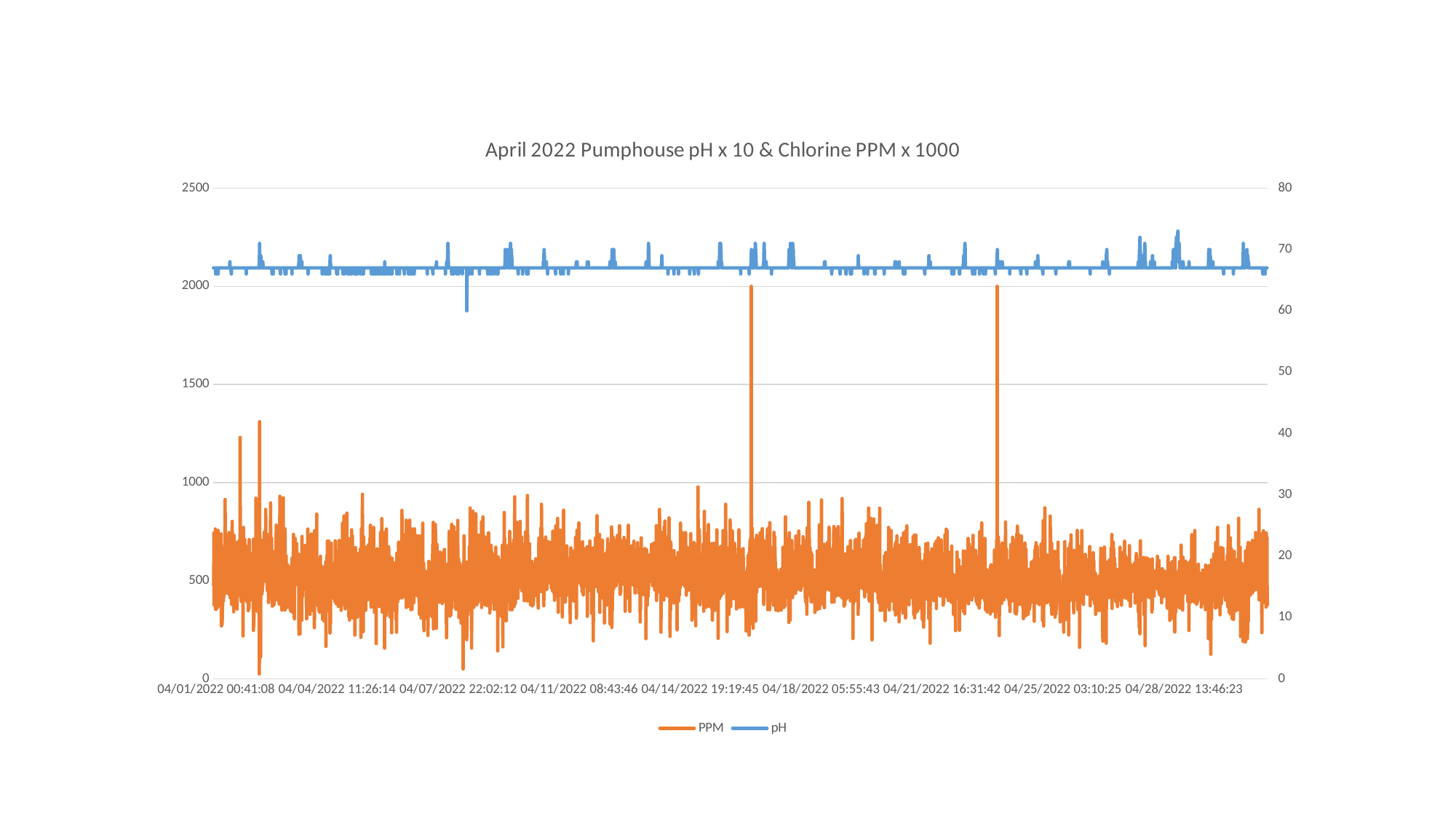
What is the last date label on the x axis? 04/28/2022 13:46:23 What is the title of the chart? April 2022 Pumphouse pH x 10 & Chlorine PPM x 1000 Which series is drawn in orange? PPM Which series is plotted higher on the chart, PPM or pH? pH How many date labels are shown along the x axis? 9 On the left axis, are the typical PPM values greater or less than 1000? less On the right axis, is the pH line mostly greater or less than 60? greater What kind of chart is shown on the slide? line chart What is the highest value shown on the right vertical axis? 80 What is the first date label on the x axis? 04/01/2022 00:41:08 How many series does the legend list? 2 What is the highest value shown on the left vertical axis? 2500